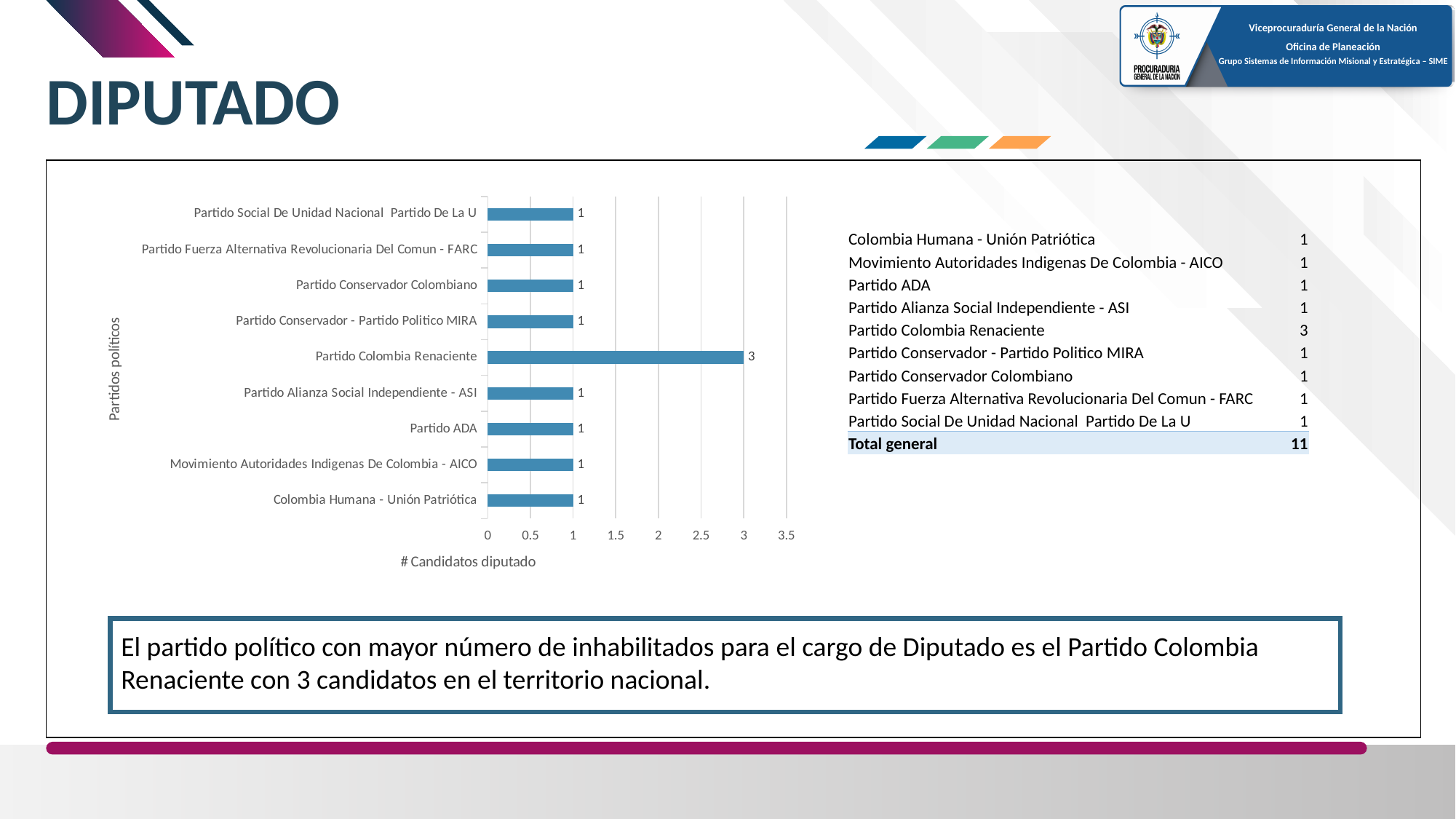
Which is larger, the value for Partido Colombia Renaciente or the value for Partido ADA? Partido Colombia Renaciente What is the value for Colombia Humana - Unión Patriótica? 1 What is the label of the y axis? Partidos políticos What is the difference between Partido Colombia Renaciente and Partido Conservador Colombiano? 2 How many parties are shown in the chart? 9 What kind of chart is shown? bar chart Is the value for Partido Colombia Renaciente greater or less than 2? greater Which party has the highest number of candidates? Partido Colombia Renaciente What is the value for Partido Colombia Renaciente? 3 What is the total of all values shown in the chart? 11 What is the value for Partido ADA? 1 What is the label of the x axis? # Candidatos diputado